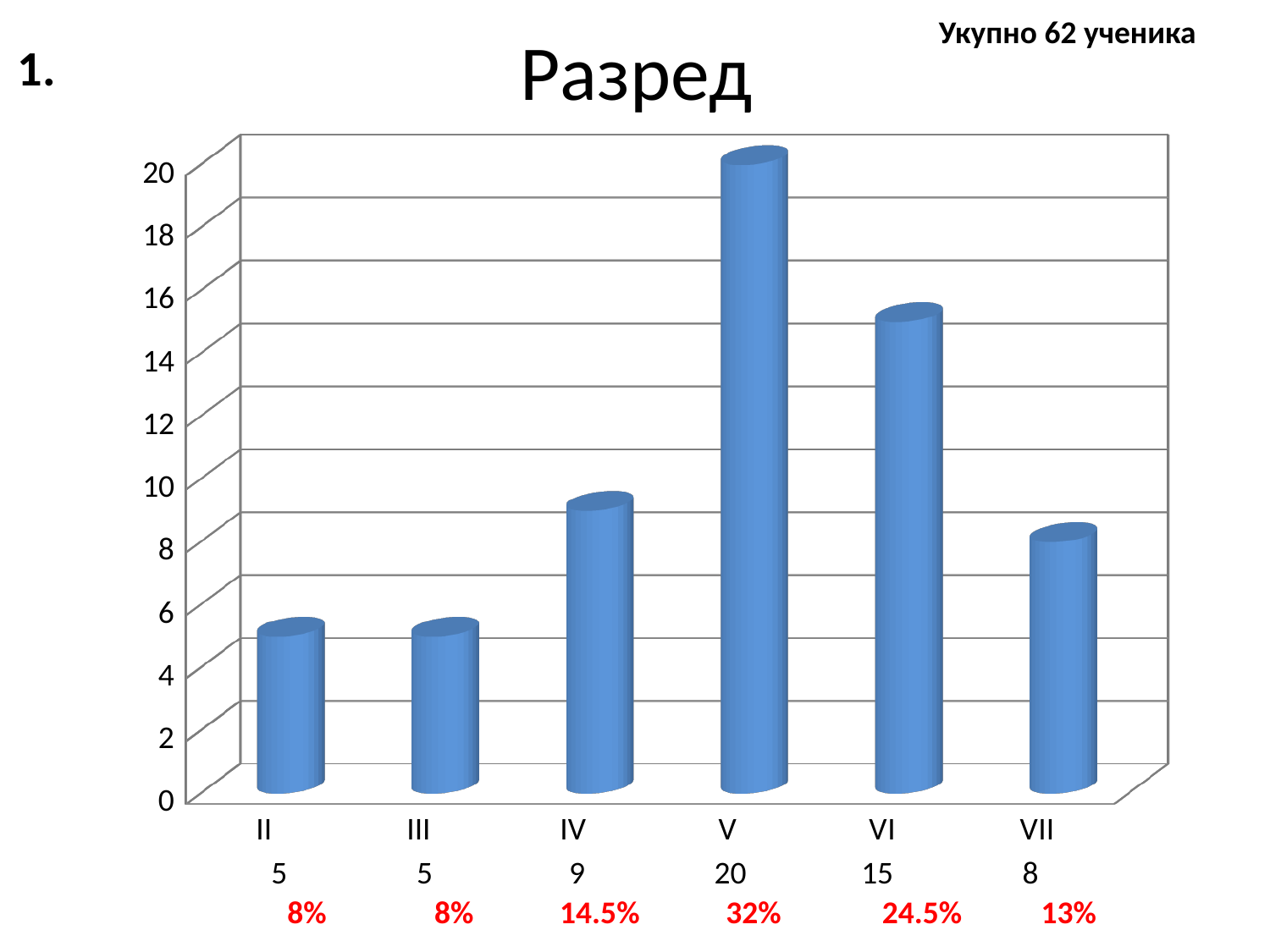
What is the value for category IV? 9 How many categories are shown on the x axis? 6 What is the difference between the values for V and VI? 5 What is the difference between the values for IV and II? 4 What is the title of the chart? Разред What percentage is shown below category V? 32% What is the value for category VI? 15 What is the value for category VII? 8 What is the value for category V? 20 What kind of chart is shown on the slide? bar chart Which category has the highest value? V Which is larger, the value for VI or the value for VII? VI